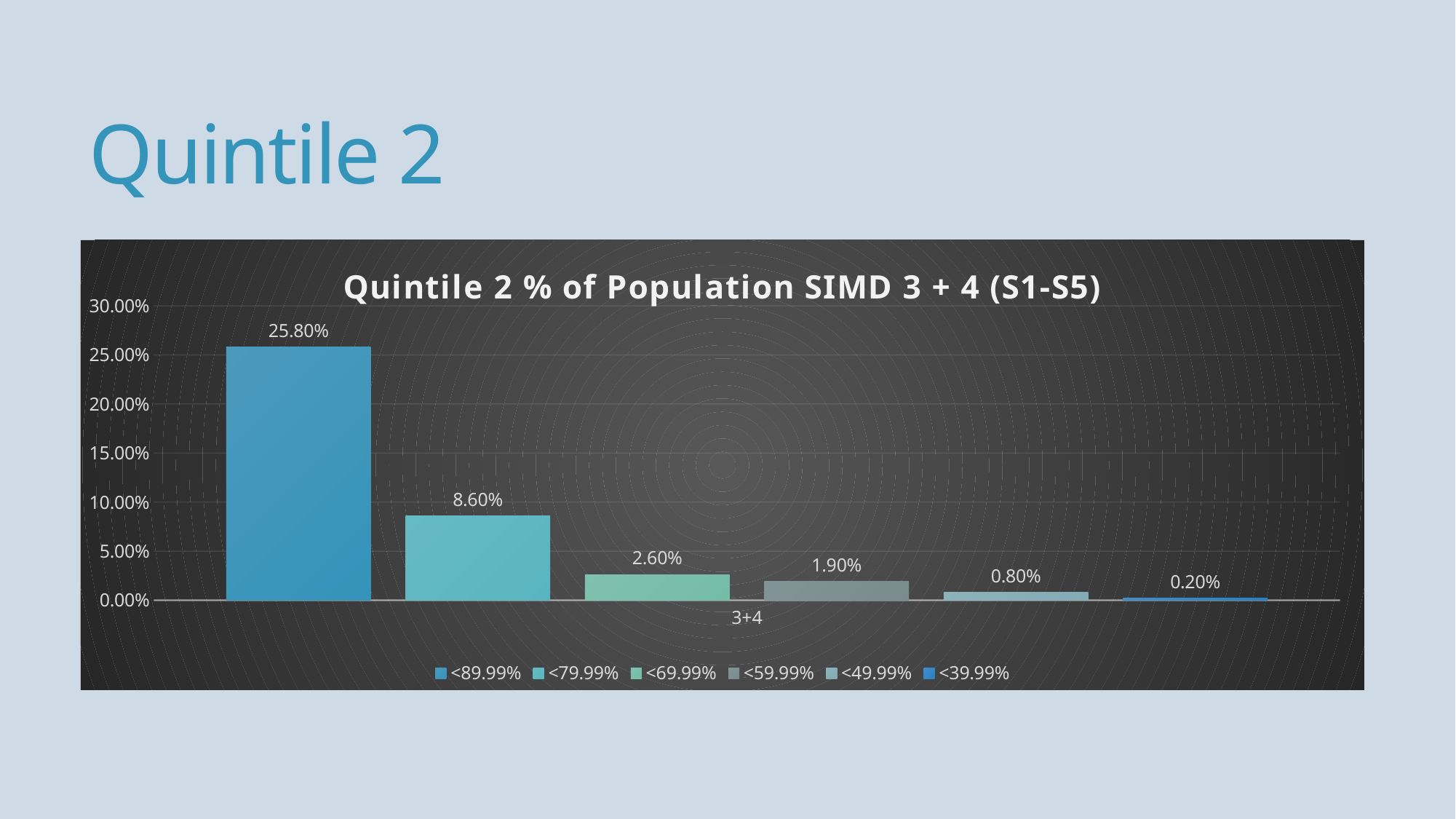
Which series has the highest value? <89.99% What kind of chart is shown? Bar chart What is the title of the chart? Quintile 2 % of Population SIMD 3 + 4 (S1-S5) What is the value for the <89.99% series? 25.80% What is the category label shown on the x axis? 3+4 What is the difference between the <89.99% and <79.99% values? 17.20% What is the value for the <79.99% series? 8.60% What is the value for the <39.99% series? 0.20% What is the value for the <69.99% series? 2.60% Which is larger, the value for <59.99% or the value for <49.99%? <59.99% How many series does the legend list? 6 Which series has the lowest value? <39.99%